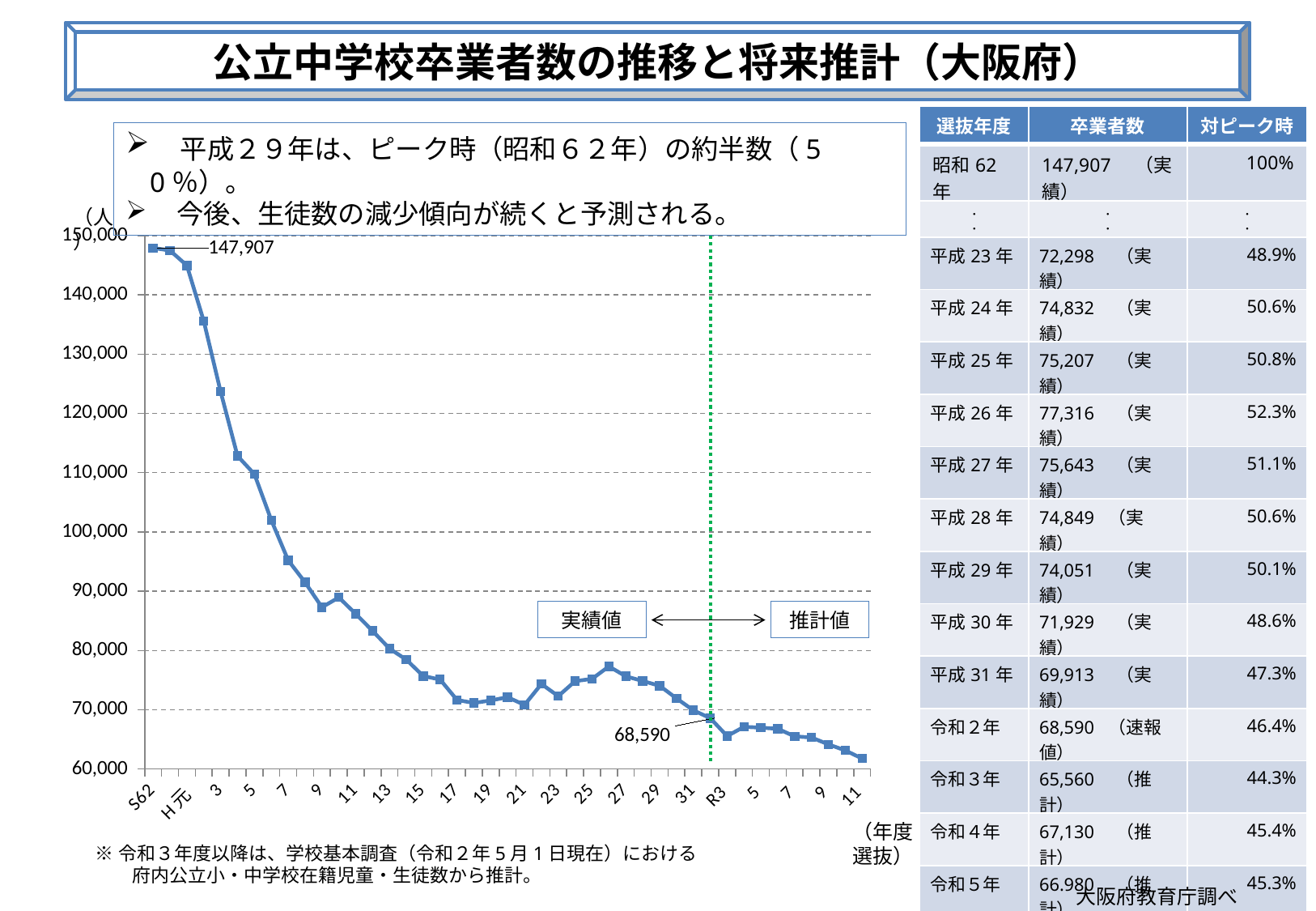
What is the value plotted for S62 (昭和62年) on the chart? 147,907 Overall, do the values rise or fall from S62 to R11 along the x axis? fall What is the difference between the labelled value at S62 (147,907) and the labelled value at R3 (68,590)? 79,317 What is the value labelled at the R3 point on the chart, where the dotted line is? 68,590 Is the value for H3 greater or less than 120,000? greater What kind of chart is shown on the slide? line chart Is the value for R11 greater or less than 70,000? less Is the value for H7 greater or less than 100,000? less What two labels does the green dotted line on the chart separate? 実績値 and 推計値 Which year on the x axis has the highest value on the chart? S62 Which is larger, the value at S62 or the value at R3? S62 What is the lowest value shown on the chart's y axis? 60,000